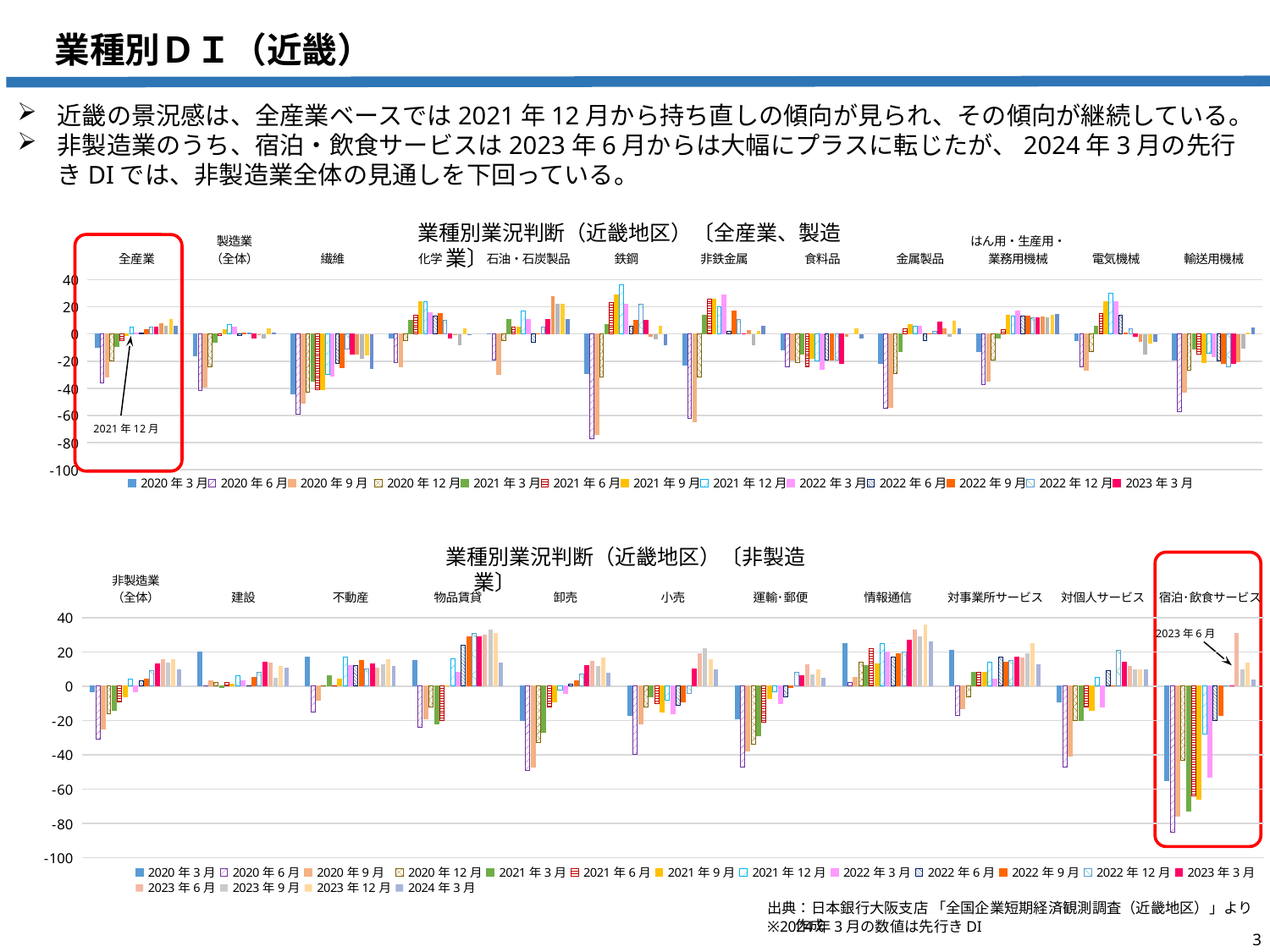
In the top chart (全産業、製造業), is the value for 全産業 in 2020年6月 greater or less than -20? less How many series does the legend of the top chart (全産業、製造業) list? 13 What kind of chart is the top chart titled 業種別業況判断（近畿地区）〔全産業、製造業〕? bar chart In the top chart (全産業、製造業), is the value for 鉄鋼 in 2020年9月 greater or less than -60? less Which category is highlighted with a red box in the bottom chart (非製造業)? 宿泊・飲食サービス In the bottom chart (非製造業), is the value for 卸売 in 2020年6月 greater or less than -20? less How many industry categories are shown on the x axis of the top chart (全産業、製造業)? 12 How many industry categories are shown on the x axis of the bottom chart (非製造業)? 11 How many series does the legend of the bottom chart (非製造業) list? 17